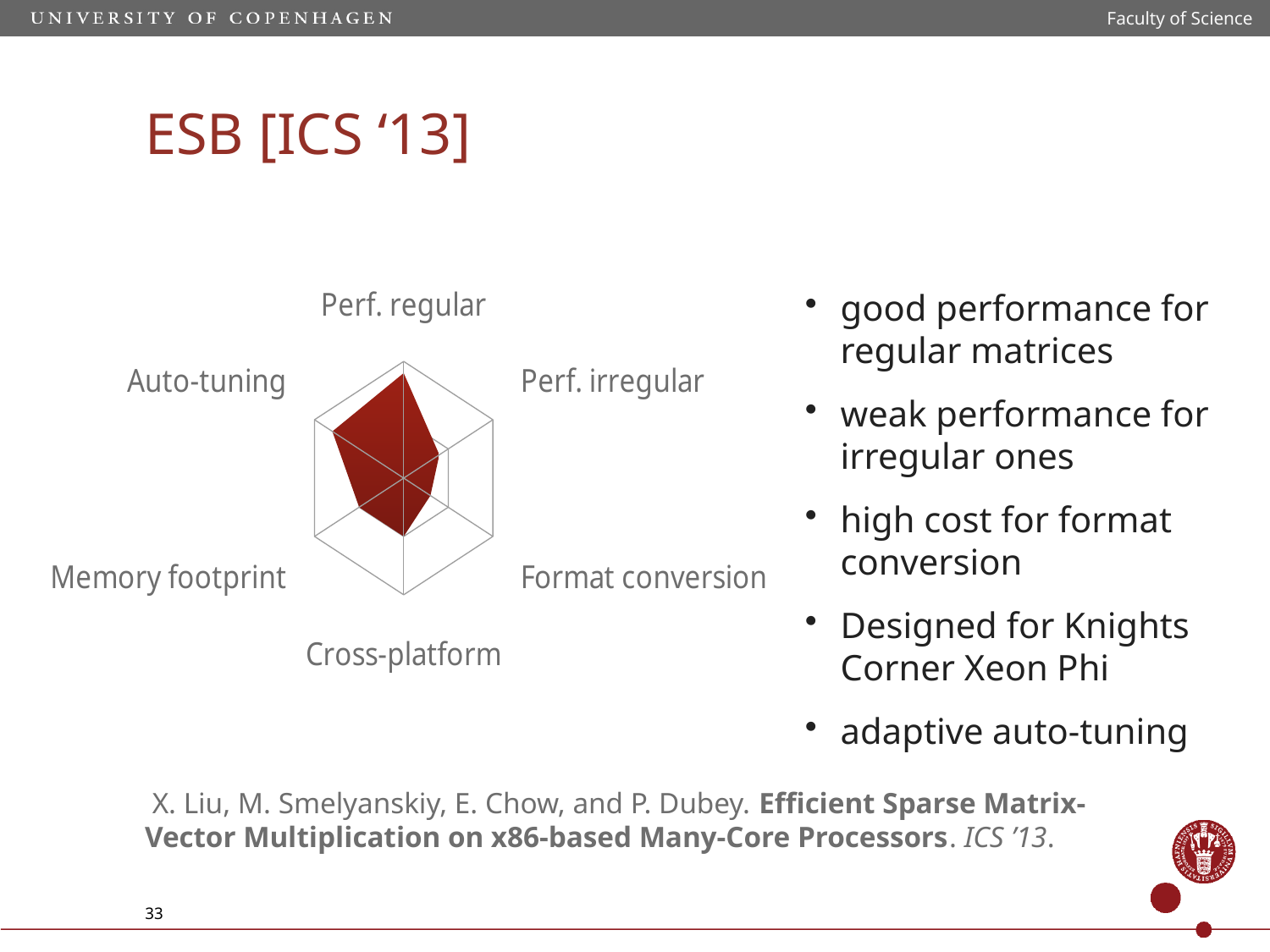
What colour is the filled area of the radar chart? Dark red Which is larger in the radar chart, Auto-tuning or Format conversion? Auto-tuning How many categories (axes) does the radar chart have? 6 Which category has the highest value in the radar chart? Perf. regular Which is larger in the radar chart, Perf. regular or Format conversion? Perf. regular Which is larger in the radar chart, Memory footprint or Perf. irregular? Memory footprint What kind of chart is shown on the slide? Radar chart Which category label appears at the top of the radar chart? Perf. regular